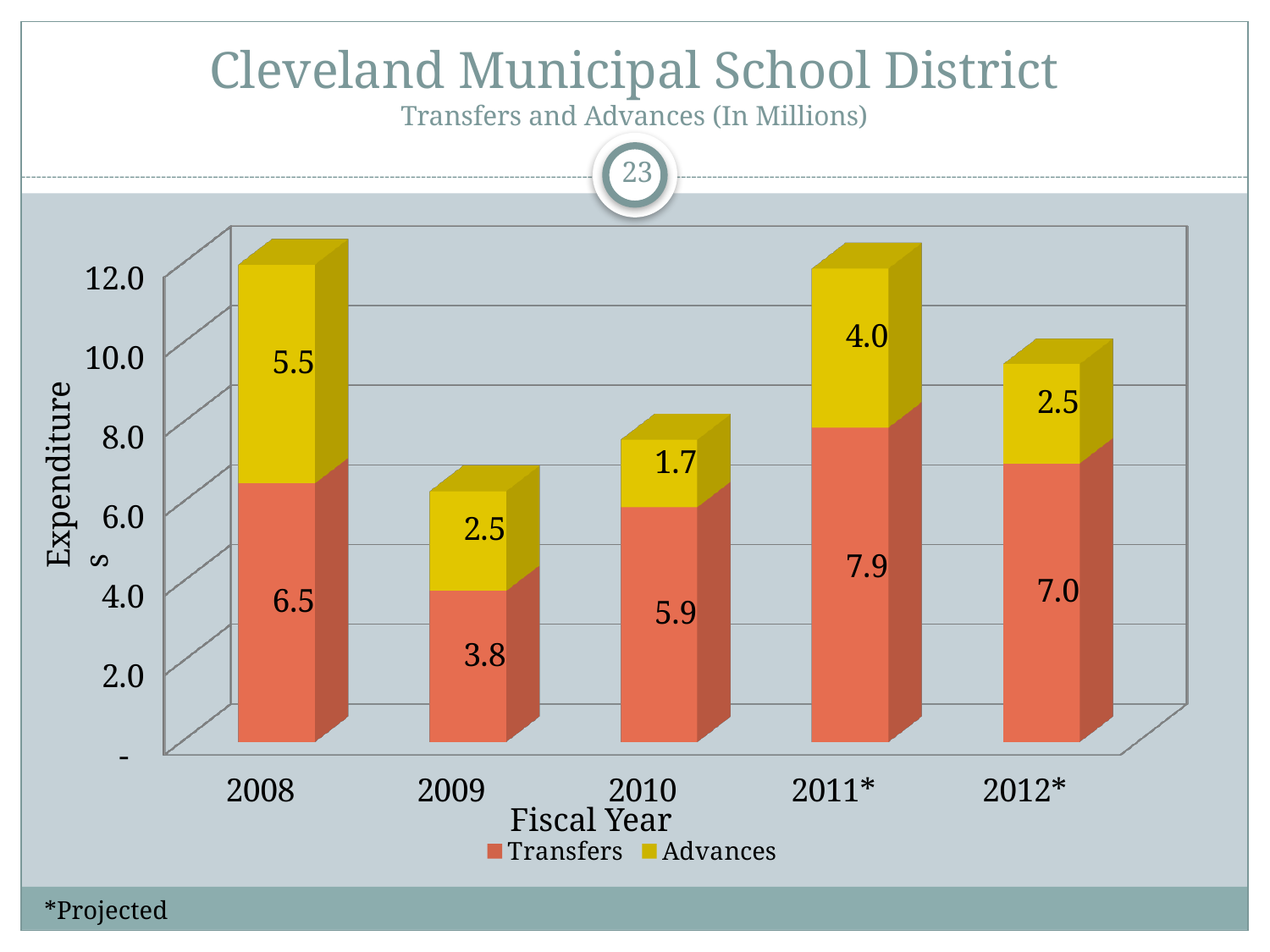
What is the total of the stacked bar for 2012*? 9.5 Which fiscal year has the highest Transfers value? 2011* How many series does the legend list? 2 What is the difference between the Transfers value for 2011* and the Transfers value for 2009? 4.1 Which is larger, the Advances value for 2008 or the Advances value for 2012*? Advances for 2008 What kind of chart is shown on the slide? Stacked bar chart What is the total of the stacked bar for 2010? 7.6 What is the Advances value for 2011*? 4.0 What is the Transfers value for 2012*? 7.0 Which fiscal year has the lowest Advances value? 2010 How many fiscal years are shown on the x axis? 5 What is the Transfers value for 2009? 3.8